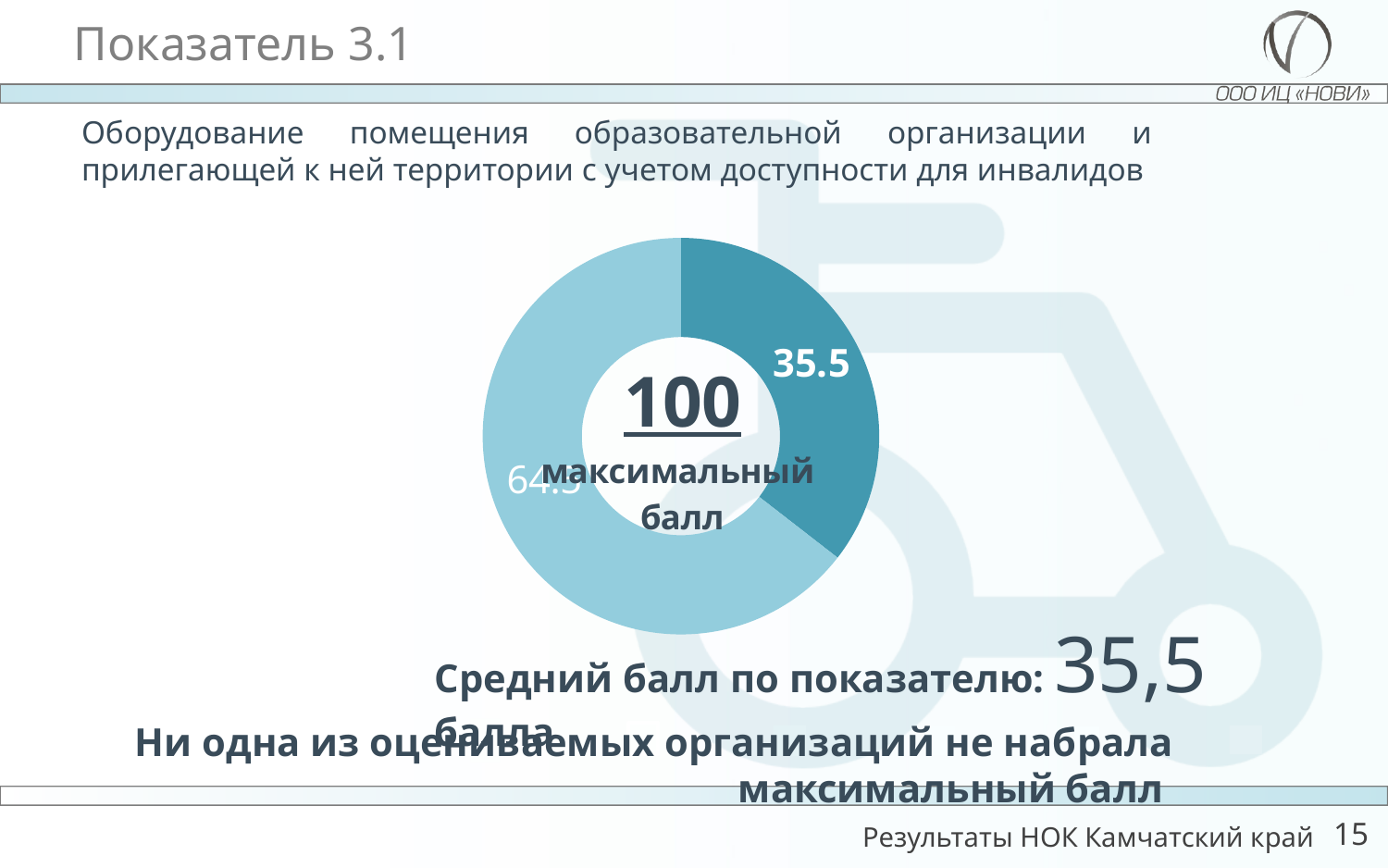
How many slices does the doughnut chart have? 2 What text accompanies the number in the centre of the doughnut chart? максимальный балл What value is labelled on the darker blue slice of the doughnut chart? 35.5 Is the value of the darker blue slice greater or less than 50? less Which slice of the doughnut chart is the smallest? the darker blue slice (35.5) What kind of chart is shown on the slide? doughnut chart What number is printed in the centre of the doughnut chart? 100 Which slice of the doughnut chart is larger, the darker blue one or the lighter blue one? the lighter blue one What is the average score for the indicator stated below the chart? 35,5 балла